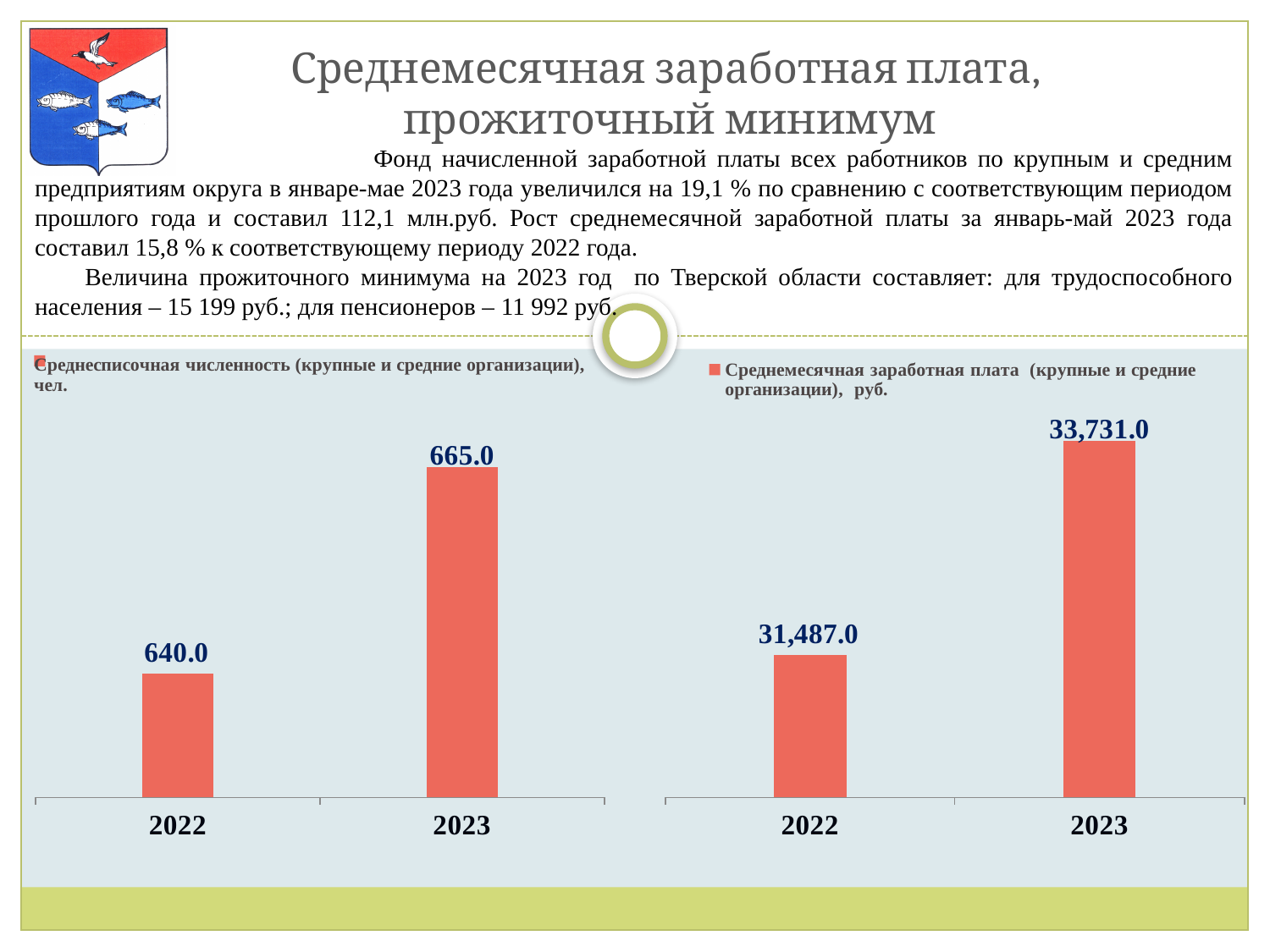
In the left chart (Среднесписочная численность), what is the difference between the 2023 and 2022 values? 25.0 In the left chart (Среднесписочная численность), which year has the higher value? 2023 In the left chart (Среднесписочная численность), what is the value for 2022? 640.0 In the right chart (Среднемесячная заработная плата), what is the difference between the 2023 and 2022 values? 2,244.0 In the left chart (Среднесписочная численность), do the values rise or fall from 2022 to 2023? rise What kind of chart is the right chart (Среднемесячная заработная плата)? bar chart In the right chart (Среднемесячная заработная плата), is the value for 2023 larger or smaller than the value for 2022? larger In the left chart (Среднесписочная численность), what is the value for 2023? 665.0 In the right chart (Среднемесячная заработная плата), what is the value for 2022? 31,487.0 In the right chart (Среднемесячная заработная плата), which year has the lower value? 2022 How many categories are shown on the x axis of the left chart (Среднесписочная численность)? 2 In the right chart (Среднемесячная заработная плата), what is the value for 2023? 33,731.0